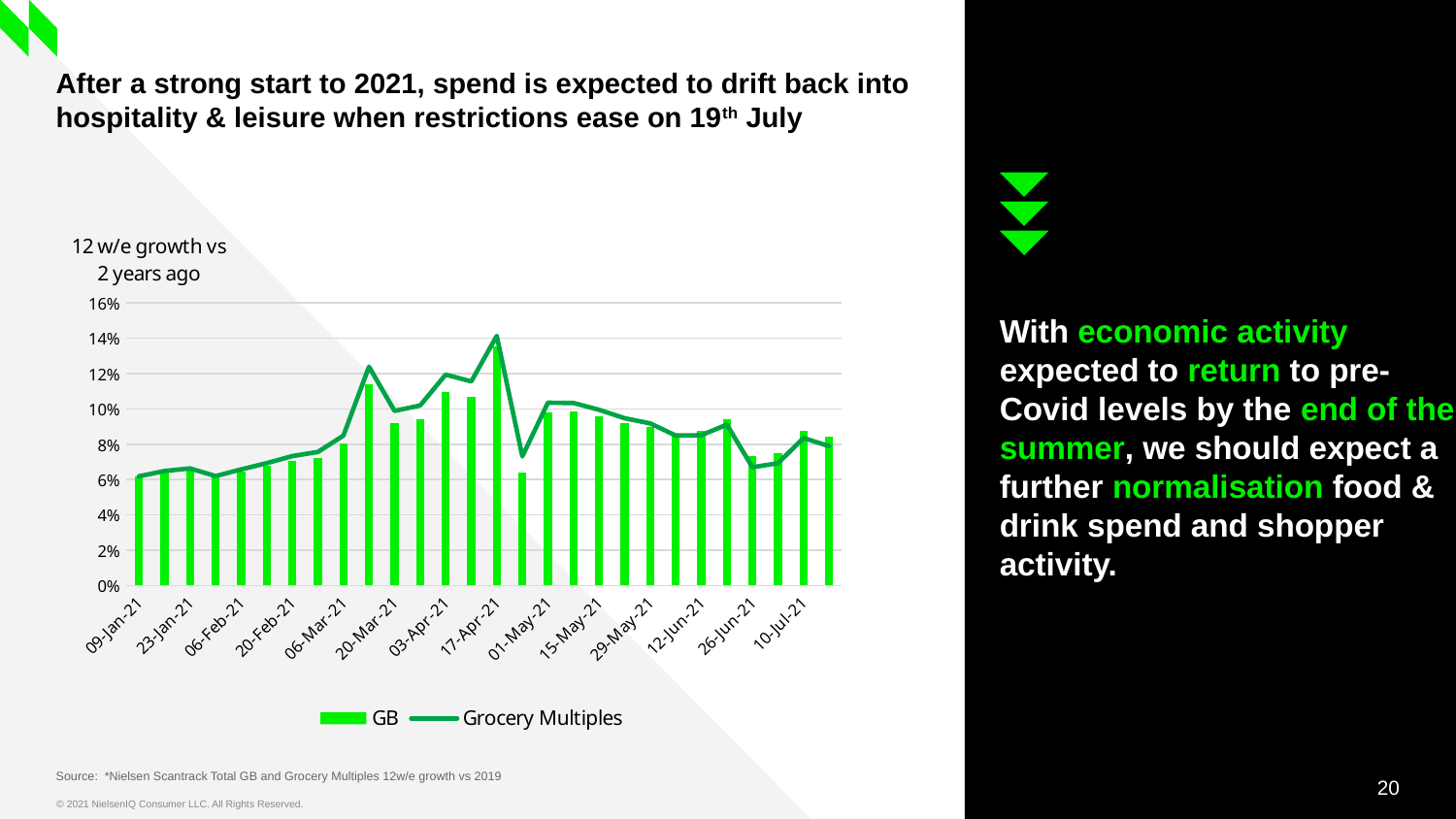
Is the Grocery Multiples value for 17-Apr-21 greater or less than 12%? greater What are the two series named in the chart legend? GB and Grocery Multiples How many date labels are shown on the x axis of the chart? 14 What is the title of the chart? 12 w/e growth vs 2 years ago Is the GB value for 09-Jan-21 greater or less than 8%? less Which is larger, the GB value for 17-Apr-21 or the GB value for 01-May-21? 17-Apr-21 Is the GB value for 17-Apr-21 greater or less than 12%? greater How many series does the chart legend list? 2 Do the GB bars generally rise or fall from 09-Jan-21 to 20-Mar-21? rise At which date does the GB bar reach its highest value? 17-Apr-21 What kind of chart is shown on the slide? A combined bar and line chart